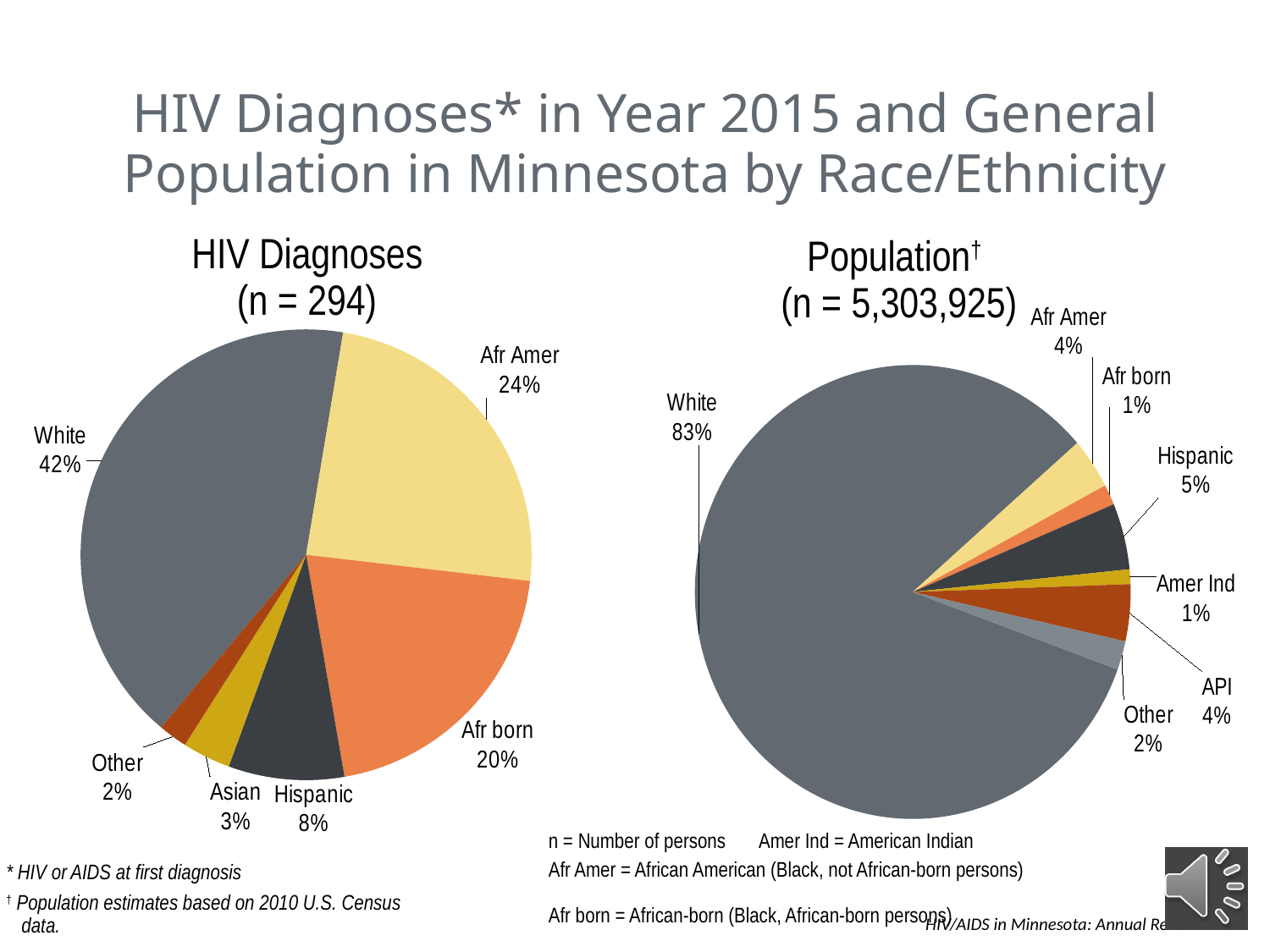
What type of chart is used on this slide? Pie chart In the Population pie chart, what percentage is labelled for Hispanic? 5% In the HIV Diagnoses pie chart, what percentage is labelled for Afr born? 20% Which is larger in the HIV Diagnoses pie chart: the Hispanic share or the Asian share? Hispanic In the HIV Diagnoses pie chart, what is the difference between the Afr Amer share and the Afr born share? 4% In the HIV Diagnoses pie chart, which labelled category has the smallest share? Other In the Population pie chart, which category has the largest slice? White In the HIV Diagnoses pie chart, which category has the largest slice? White In the Population pie chart, what share of the population is White? 83% In the HIV Diagnoses pie chart, what share of diagnoses is White? 42% How many categories are labelled in the Population pie chart? 7 What is the n value shown under the Population chart title? 5,303,925